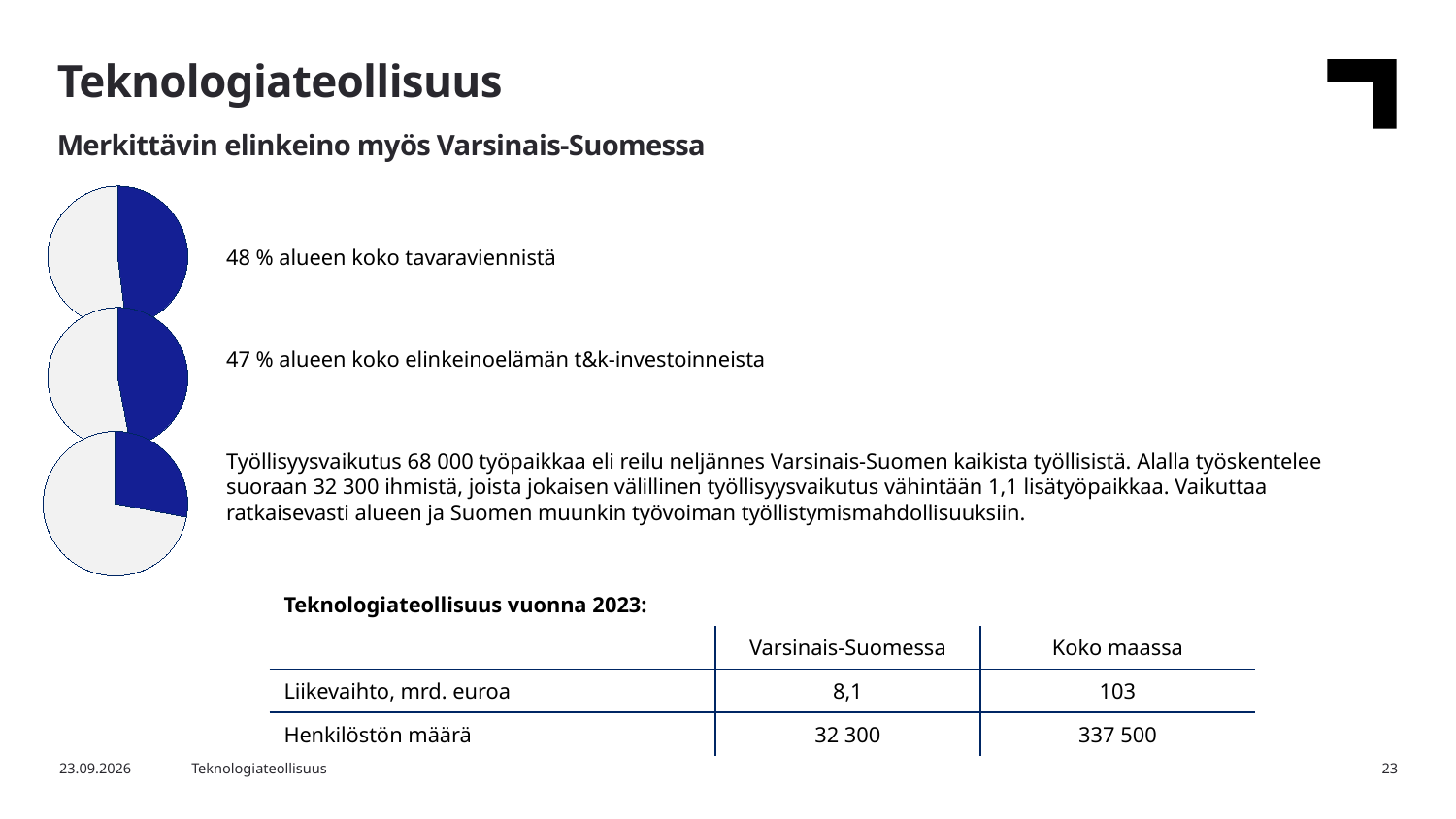
How many pie charts are on the slide? 3 In the top pie chart, what share of the region's total goods exports does the highlighted slice represent? 48 % Is the highlighted slice larger in the middle pie chart or in the bottom pie chart? Middle What text accompanies the top pie chart? 48 % alueen koko tavaraviennistä How many slices does each pie chart have? 2 What colour is the highlighted slice in the pie charts? Blue Is the highlighted slice larger in the top pie chart or in the bottom pie chart? Top Which pie chart has the smallest highlighted slice: the top, middle or bottom one? Bottom In the middle pie chart, what share of the region's business R&D investments does the highlighted slice represent? 47 % What kind of charts are shown on the left side of the slide? Pie charts